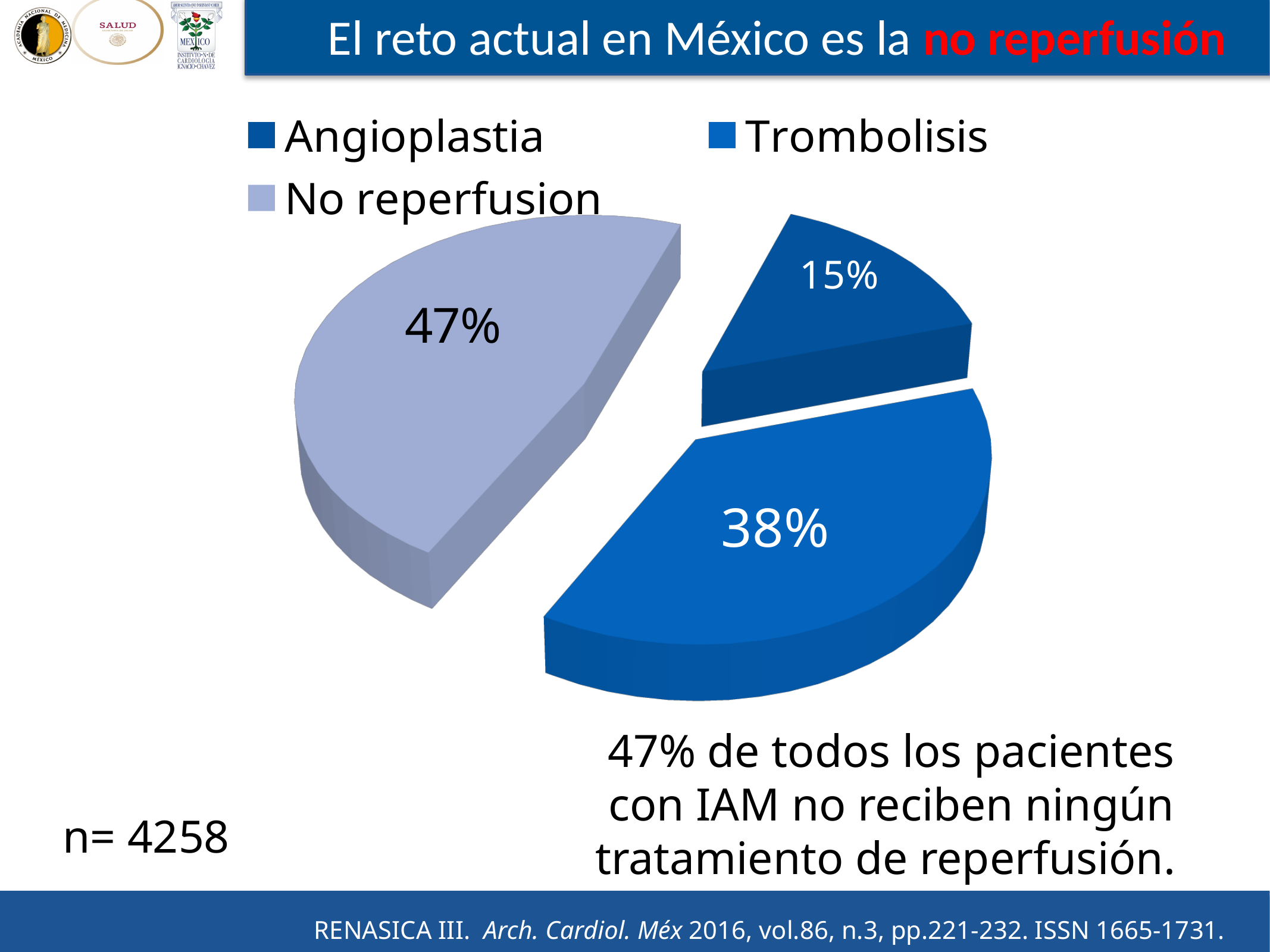
What is the difference in percentage points between the No reperfusion slice and the Trombolisis slice? 9 How many entries does the legend list? 3 What is the difference in percentage points between the Trombolisis slice and the Angioplastia slice? 23 What kind of chart is shown on the slide? Pie chart What percentage of the pie is labelled for Trombolisis? 38% Which category has the largest slice of the pie? No reperfusion What percentage of the pie is labelled for Angioplastia? 15% Which is larger, the Trombolisis slice or the Angioplastia slice? Trombolisis What percentage of the pie is labelled for No reperfusion? 47% How many slices does the pie chart have? 3 Which category has the smallest slice of the pie? Angioplastia What colour is the No reperfusion slice in the pie chart? Light blue